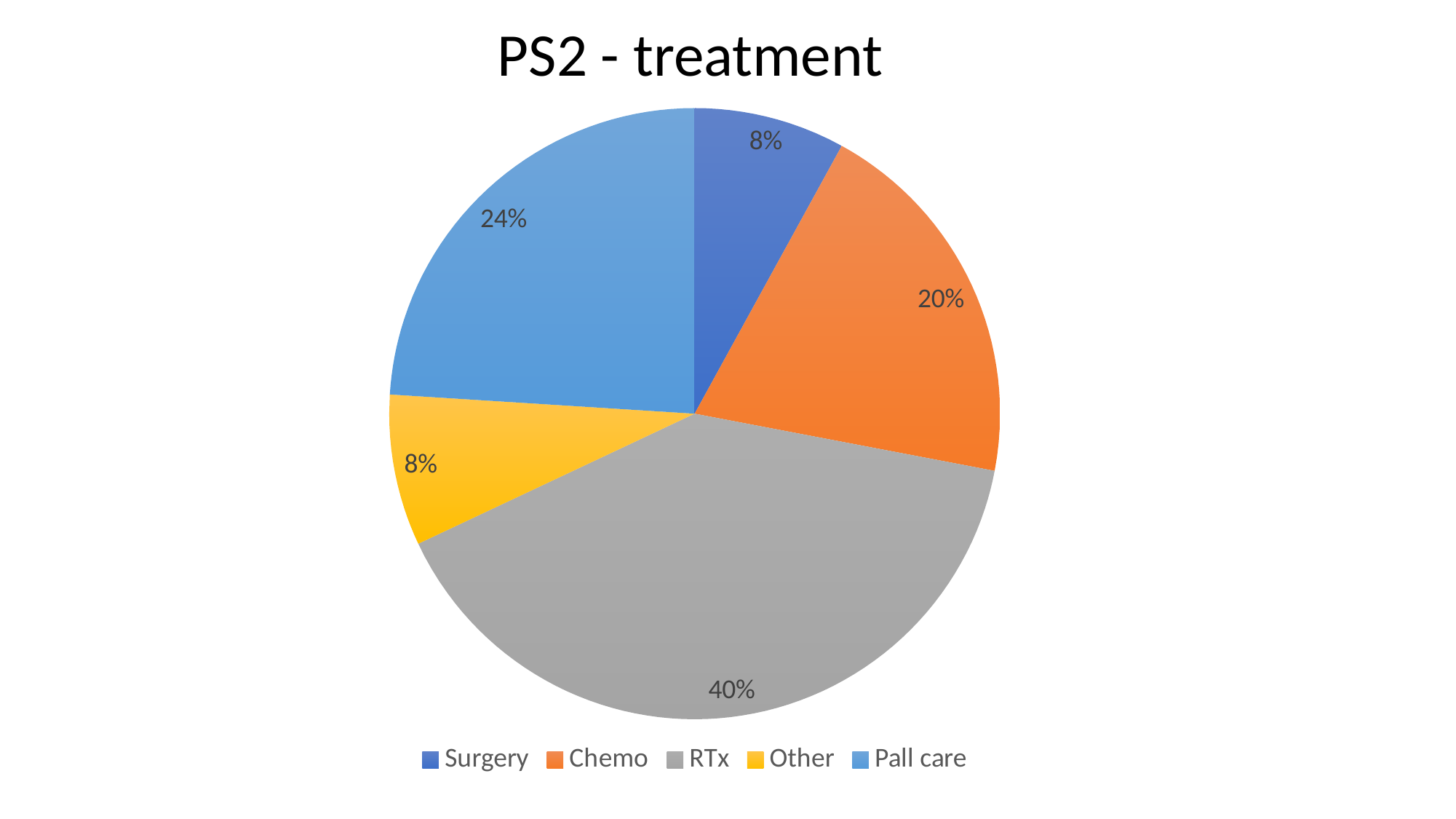
What type of chart is shown on the slide? Pie chart What percentage is shown for Chemo? 20% How many categories are shown in the pie chart? 5 What is the title of the chart? PS2 - treatment What percentage is shown for Surgery? 8% Which is larger, Pall care or Chemo? Pall care Which treatment category has the largest slice? RTx What is the difference in percentage points between RTx and Pall care? 16 What percentage is shown for Pall care? 24% Which category is shown in grey? RTx What is the difference in percentage points between Chemo and Surgery? 12 What share of the pie does RTx represent? 40%